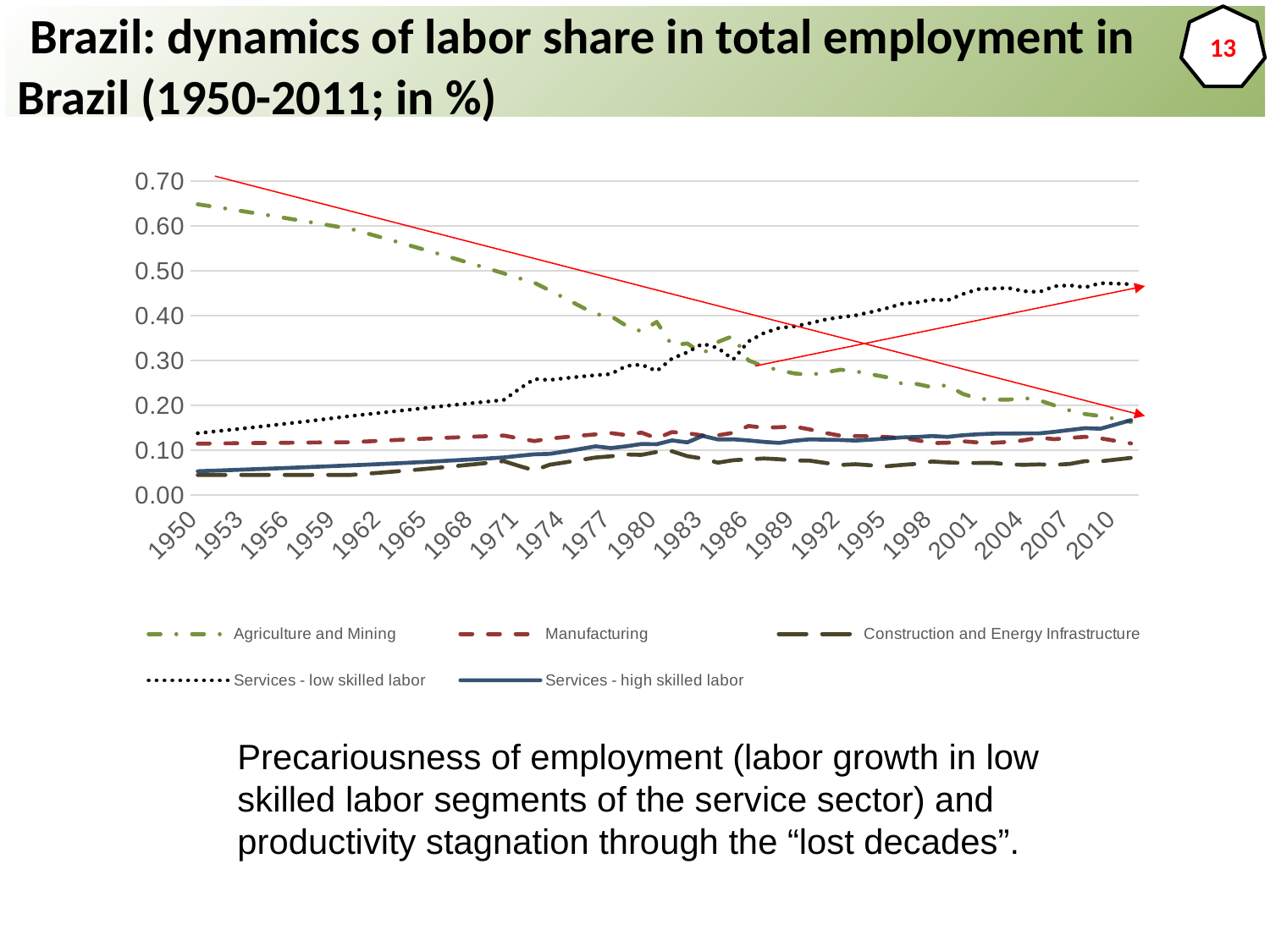
Which series has the highest value in 1950? Agriculture and Mining Which series has the lowest value in 2010? Construction and Energy Infrastructure In 1995, which is larger: Services - low skilled labor or Agriculture and Mining? Services - low skilled labor Is the value for Agriculture and Mining in 1950 greater or less than 0.60? greater Does the Agriculture and Mining series rise or fall from 1950 to 2010? fall How many series does the legend list? 5 How many year labels are shown along the x axis? 21 Which series has the highest value in 2010? Services - low skilled labor Which series is drawn as a solid blue line? Services - high skilled labor Is the value for Services - low skilled labor in 2010 greater or less than 0.40? greater Is the value for Manufacturing in 1950 greater or less than 0.20? less What kind of chart is shown on the slide? line chart